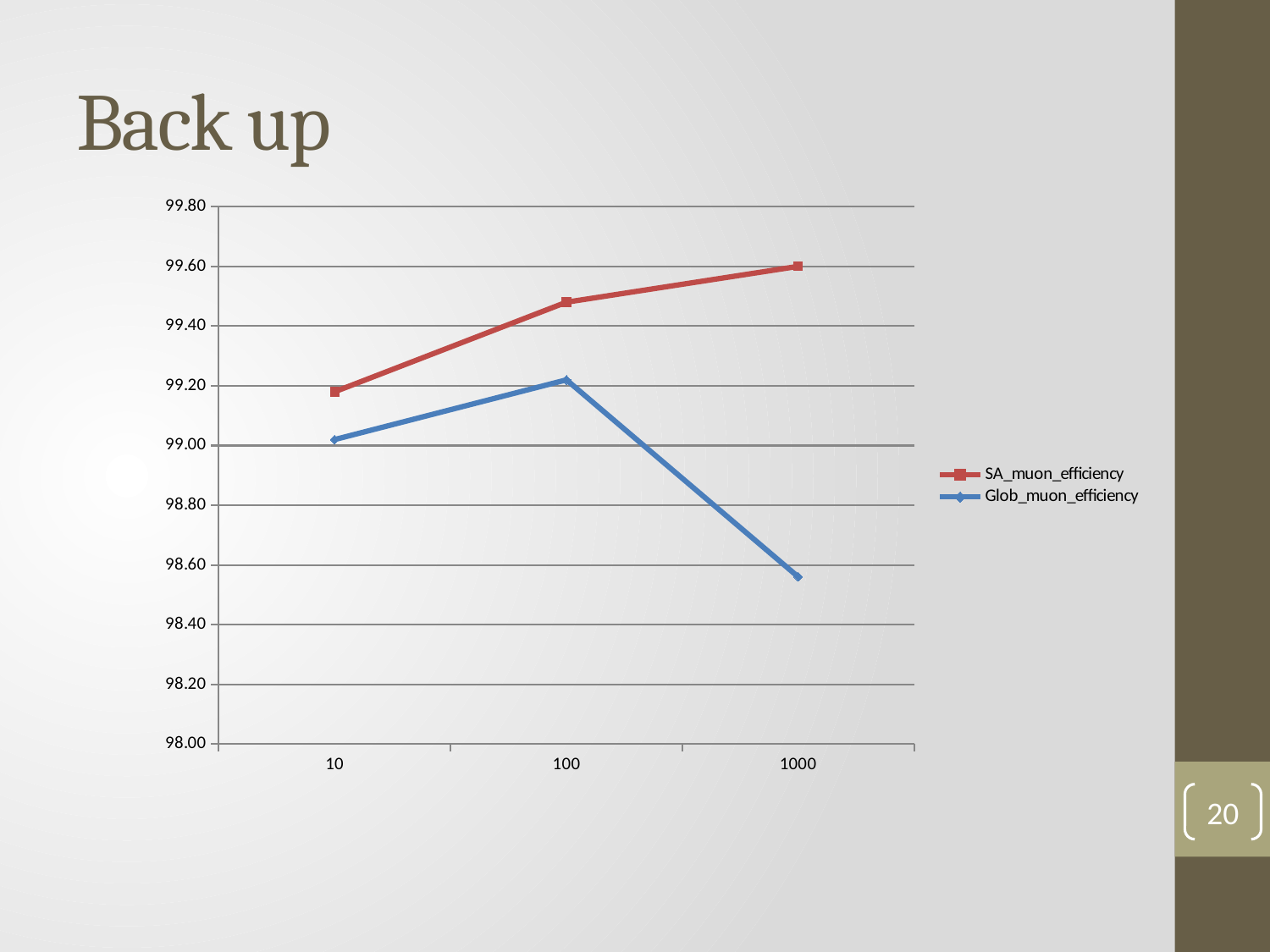
What kind of chart is shown on the slide? line chart Is the value of SA_muon_efficiency at x = 100 greater or less than 99.40? greater Does the SA_muon_efficiency series rise or fall as the x axis goes from 10 to 1000? rise Is the value of Glob_muon_efficiency at x = 10 greater or less than 99.20? less At which x-axis value is Glob_muon_efficiency highest? 100 What colour is the line for the SA_muon_efficiency series? red At x = 1000, which series has the larger value, SA_muon_efficiency or Glob_muon_efficiency? SA_muon_efficiency At which x-axis value is Glob_muon_efficiency lowest? 1000 How many x-axis categories are plotted on the chart? 3 How many series does the legend list? 2 Is the value of Glob_muon_efficiency at x = 1000 greater or less than 98.80? less At which x-axis value is SA_muon_efficiency lowest? 10